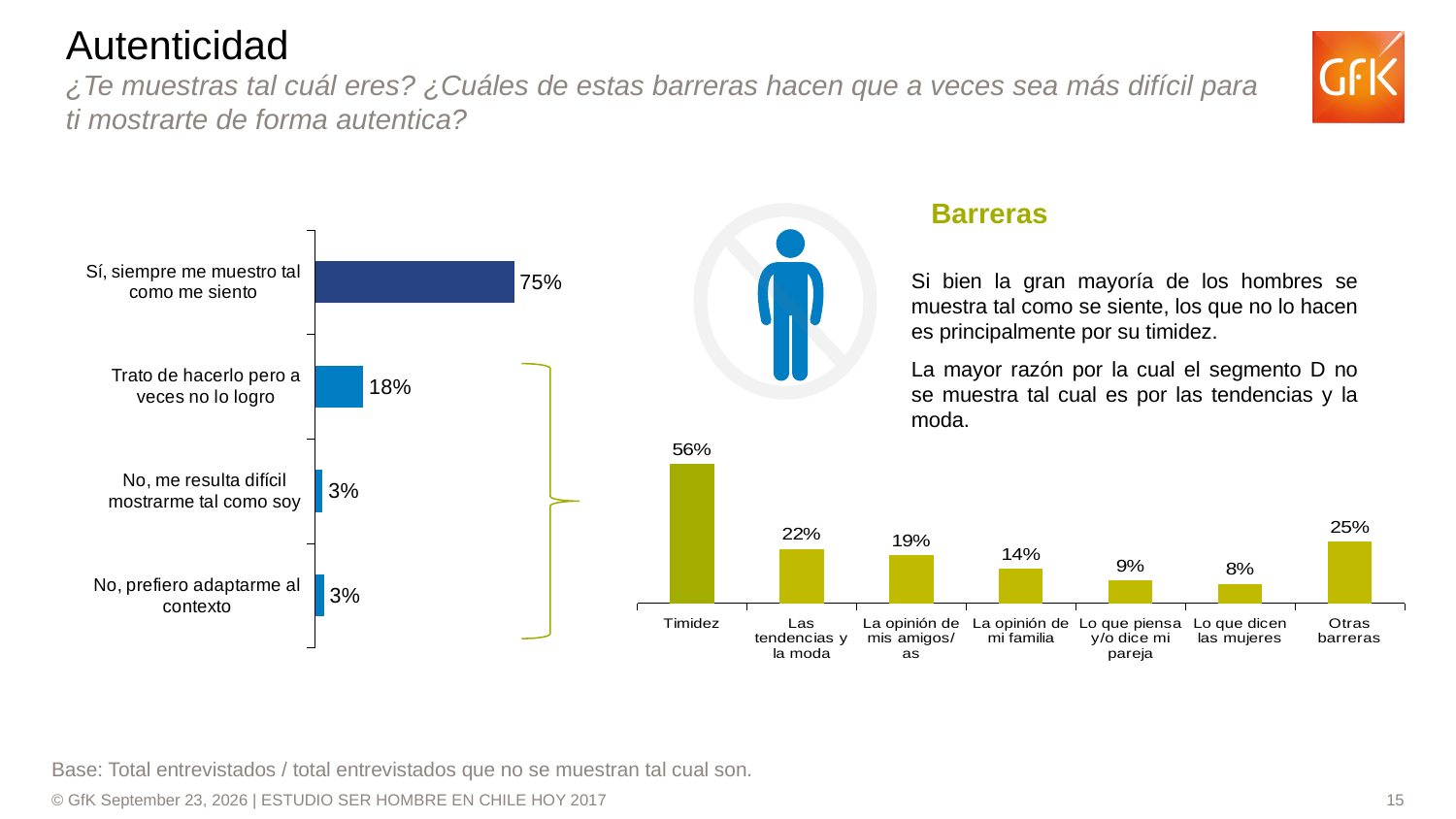
In the "Barreras" chart, what is the difference between "Timidez" and "Otras barreras"? 31 percentage points In the horizontal bar chart on the left, what is the difference between "Sí, siempre me muestro tal como me siento" and "Trato de hacerlo pero a veces no lo logro"? 57 percentage points In the horizontal bar chart on the left, how many categories are shown? 4 In the "Barreras" chart, which is larger: "Otras barreras" or "La opinión de mis amigos/as"? Otras barreras In the "Barreras" chart, how many categories are shown? 7 In the "Barreras" chart, what is the value for "Timidez"? 56% In the horizontal bar chart on the left, which category has the highest value? Sí, siempre me muestro tal como me siento In the horizontal bar chart on the left, what is the value for "Trato de hacerlo pero a veces no lo logro"? 18% In the "Barreras" chart, which category has the lowest value? Lo que dicen las mujeres What type of chart is the "Barreras" chart? Bar chart In the horizontal bar chart on the left, what is the value for "Sí, siempre me muestro tal como me siento"? 75% In the "Barreras" chart, what is the value for "Las tendencias y la moda"? 22%